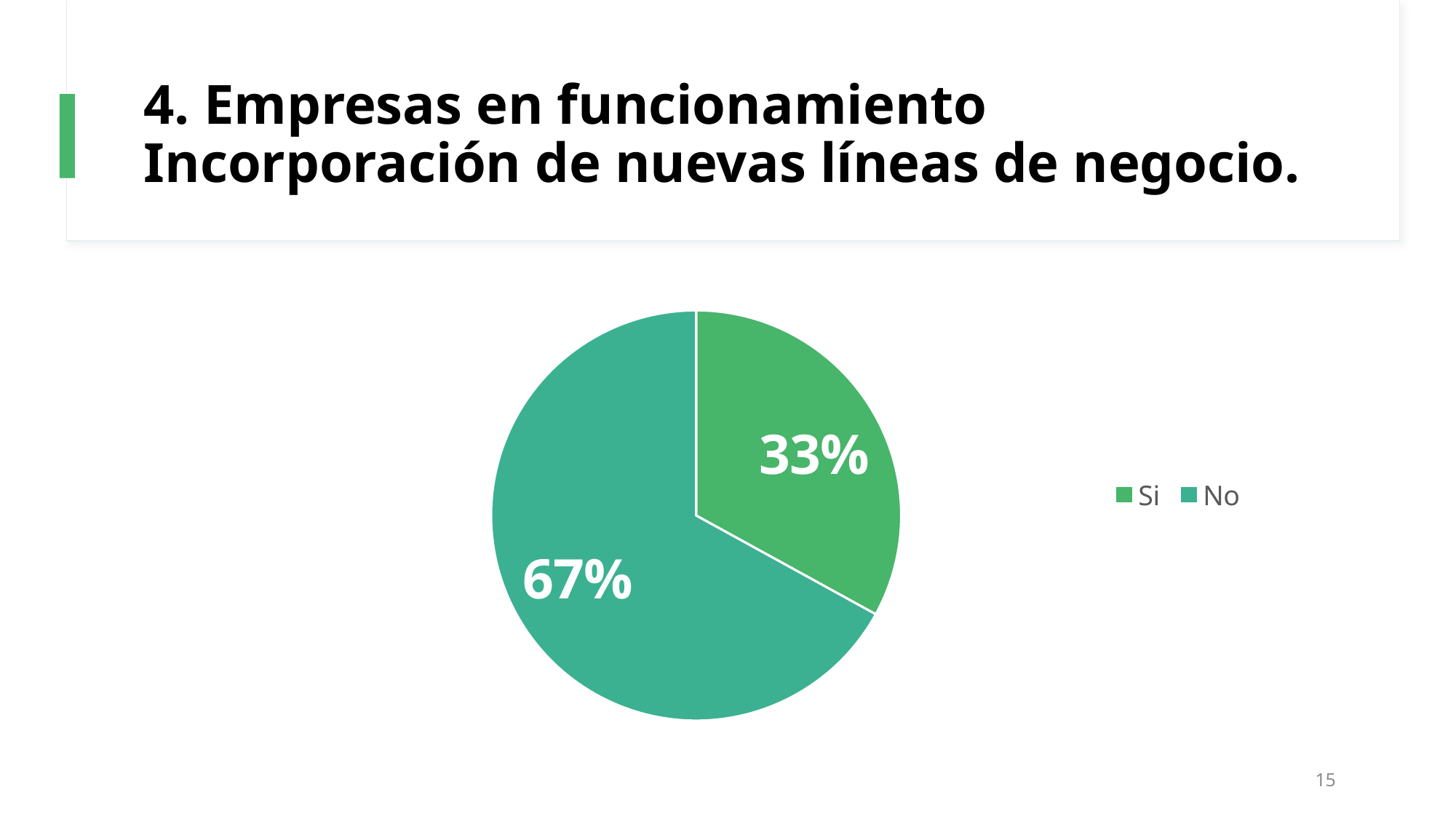
How many slices does the pie chart have? 2 What colour is the "Si" slice? green What kind of chart is shown on the slide? pie chart Where is the legend positioned relative to the pie chart? to the right How many entries does the legend list? 2 Which slice is the largest? No What is the difference in percentage points between the "No" slice and the "Si" slice? 34 What share of the pie does the "No" slice represent? 67% What percentage is shown for the "Si" slice? 33% Which is larger, the "Si" slice or the "No" slice? No Which slice is the smallest? Si What percentage is shown for the "No" slice? 67%